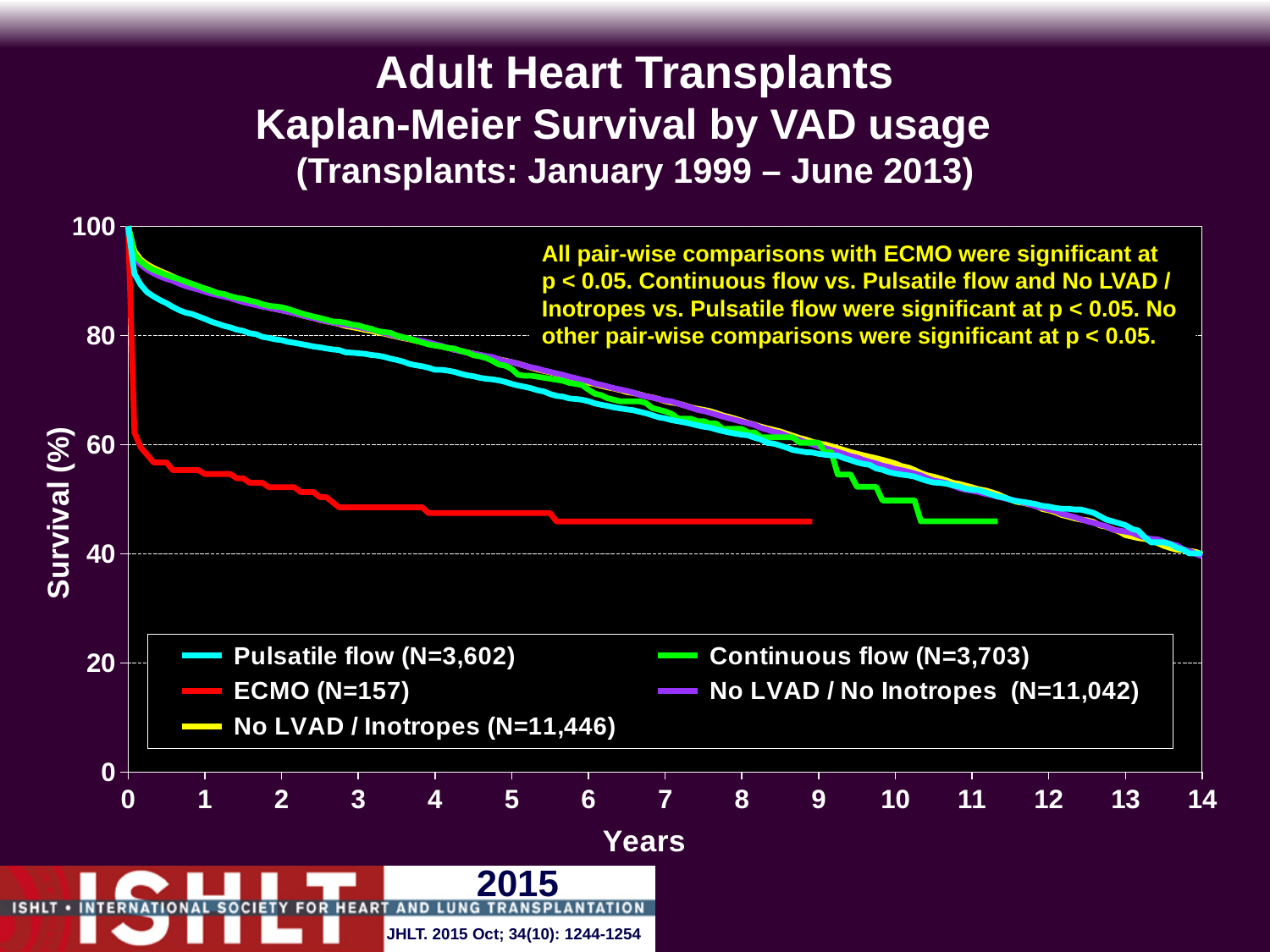
What kind of chart is shown on the slide? Line chart Is the survival for ECMO at 5 years greater or less than 60? less Do the survival curves rise or fall as years increase? fall How many series does the legend list? 5 Is the survival for Continuous flow at 1 year greater or less than 80? greater What is the N shown in the legend for ECMO? 157 What is the N shown in the legend for Continuous flow? 3,703 Is the survival for ECMO at 1 year greater or less than 60? less Which series has the lowest survival at 5 years? ECMO At 5 years, which is higher: survival for Continuous flow or for ECMO? Continuous flow